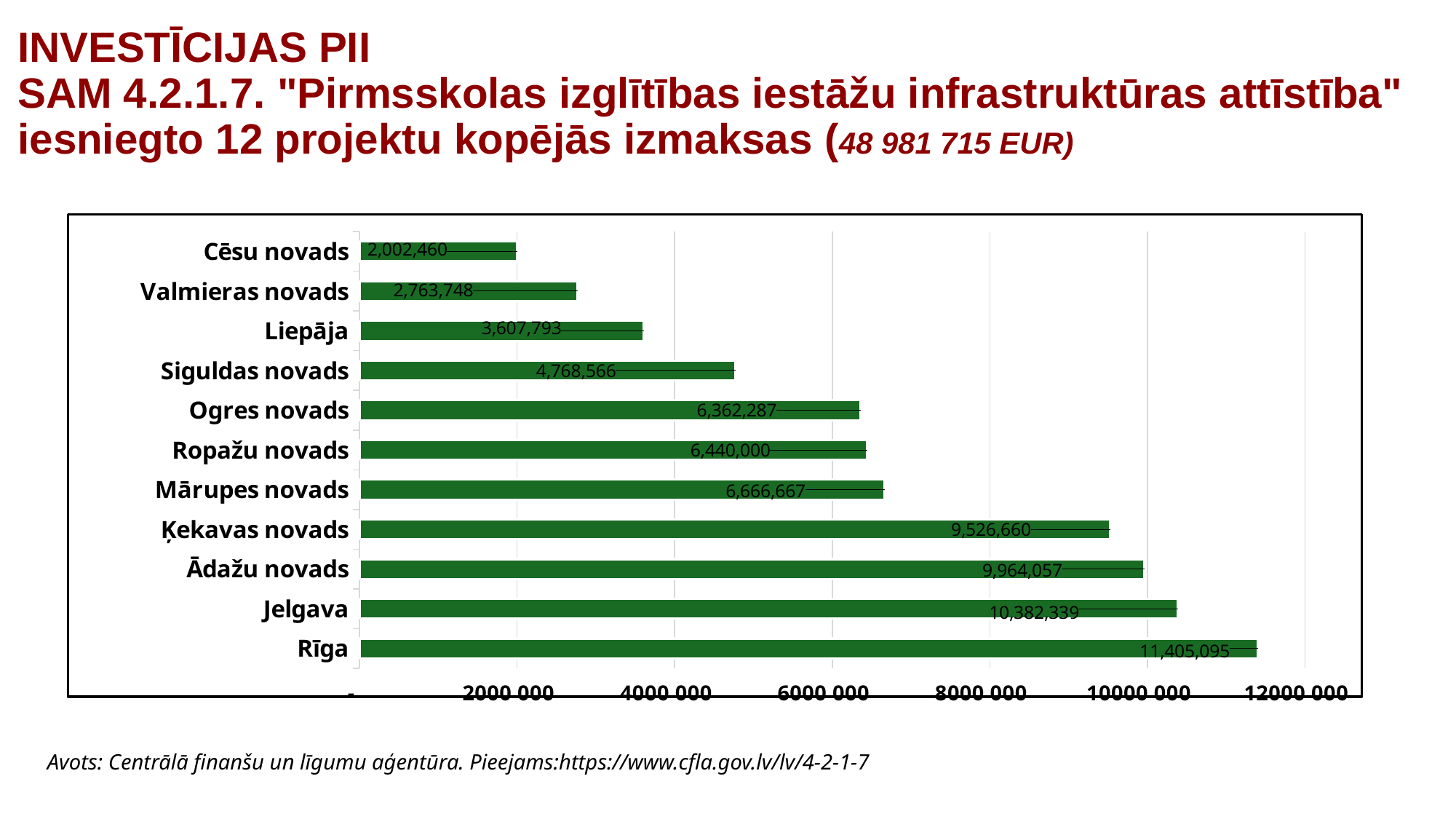
What is the value for Rīga? 11,405,095 Which is larger, the value for Liepāja or the value for Ogres novads? Ogres novads How many categories are shown in the chart? 11 What kind of chart is shown on the slide? bar chart What is the value for Ropažu novads? 6,440,000 Is the value for Siguldas novads greater or less than 4000 000? greater Which category has the highest value? Rīga What is the difference between the values for Ādažu novads and Ķekavas novads? 437,397 What colour are the bars in the chart? green What is the value for Siguldas novads? 4,768,566 Which category has the lowest value? Cēsu novads What is the difference between the values for Rīga and Jelgava? 1,022,756